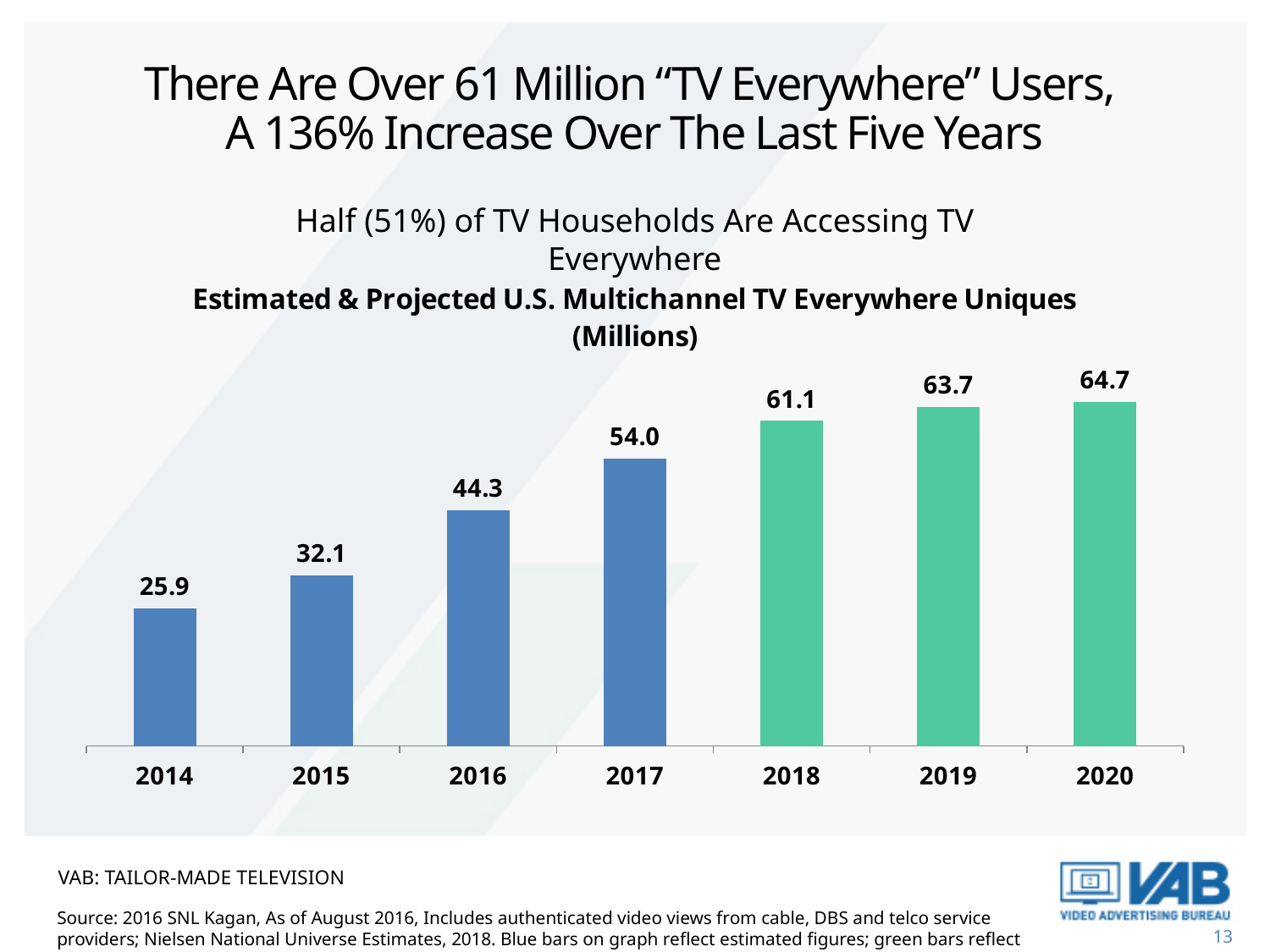
What is the value for 2020? 64.7 Which is larger, the value for 2017 or the value for 2019? 2019 What is the difference between the values for 2018 and 2014? 35.2 What kind of chart is shown on the slide? Bar chart What is the title of the chart? Estimated & Projected U.S. Multichannel TV Everywhere Uniques (Millions) How many years are shown on the x axis? 7 What is the value for 2014? 25.9 Which year has the highest value? 2020 What is the difference between the values for 2016 and 2015? 12.2 What is the value for 2017? 54.0 Do the values rise or fall from 2014 to 2020? Rise Which year has the lowest value? 2014